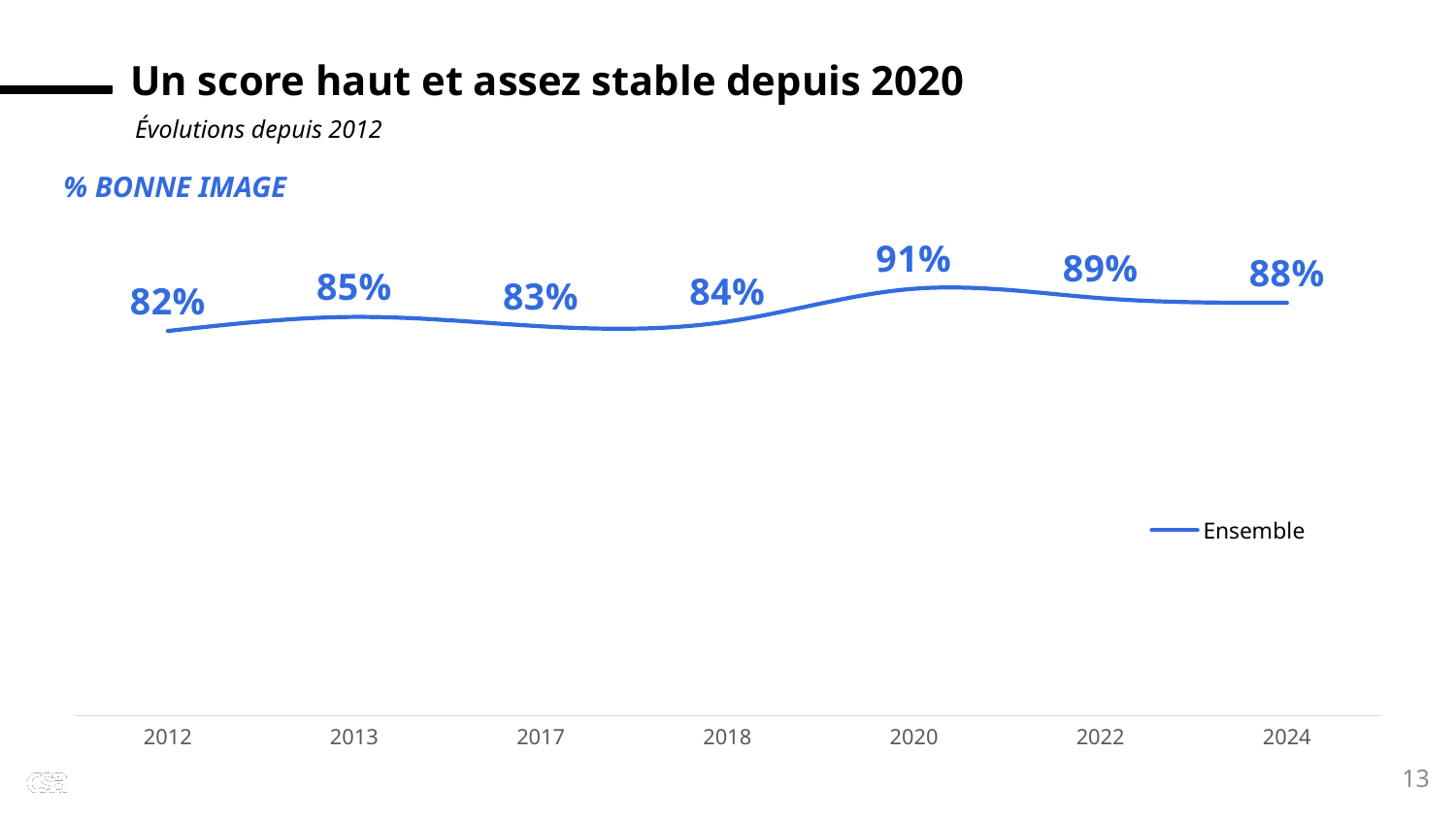
What is the difference between the values for 2020 and 2012? 9% What kind of chart is shown? line chart What series name does the legend show? Ensemble What is the value for 2024? 88% What is the value for 2020? 91% What is the value for 2017? 83% Which is larger, the value for 2013 or the value for 2018? 2013 How many years are plotted on the chart? 7 What is the value for 2012? 82% Which year has the lowest value? 2012 What is the difference between the values for 2022 and 2024? 1% Which year has the highest value? 2020